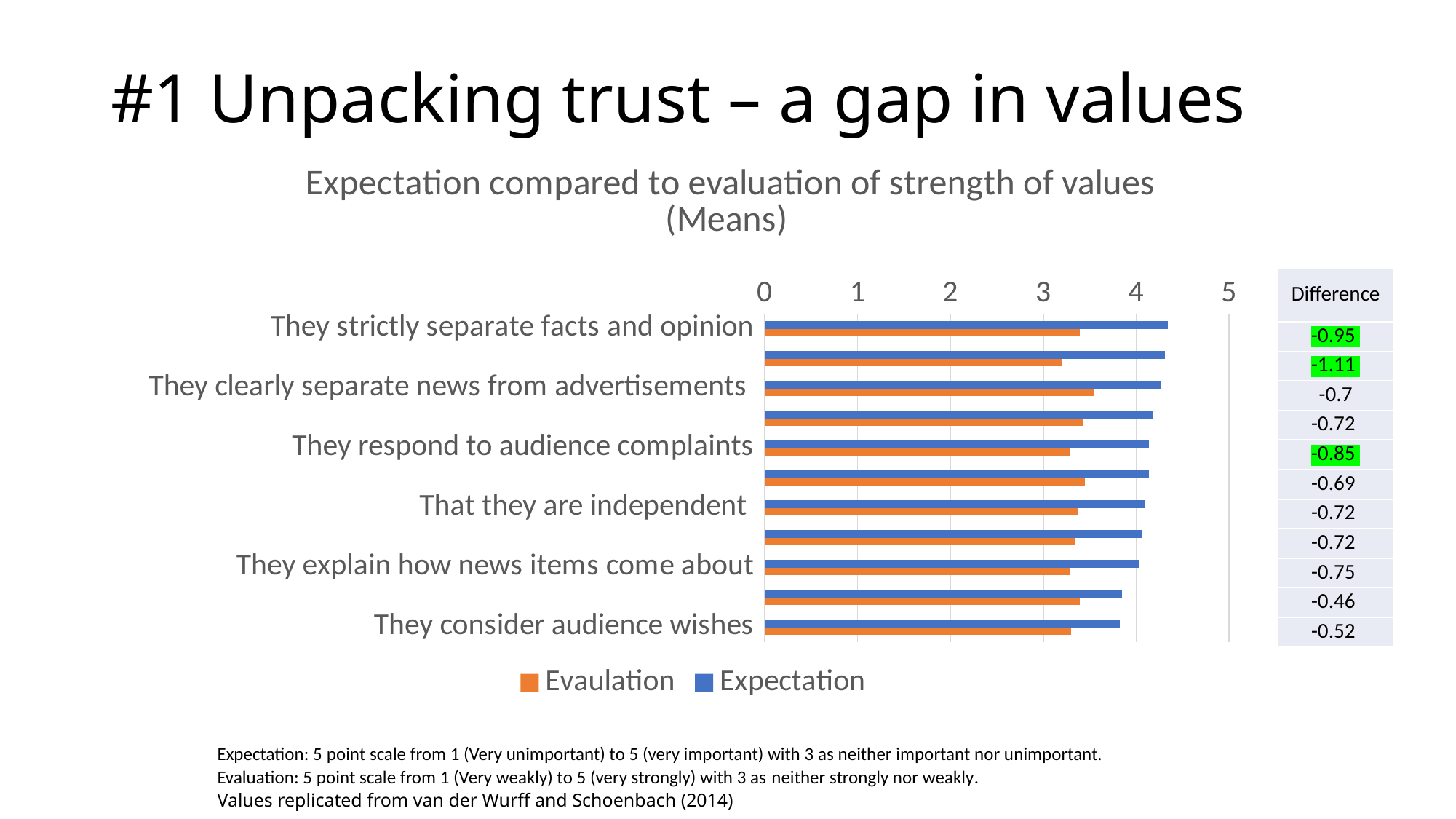
How many series does the chart legend list? 2 What kind of chart is shown on the slide? Bar chart Is the Expectation value for 'They consider audience wishes' greater or less than 4? less Is the Evaulation value for 'They consider audience wishes' greater or less than 3? greater Is the Expectation value for 'They strictly separate facts and opinion' greater or less than 4? greater What are the two series named in the chart legend? Evaulation and Expectation For 'They respond to audience complaints', which is larger: the Expectation value or the Evaulation value? Expectation For 'That they are independent', which series has the longer bar, Expectation or Evaulation? Expectation What is the highest value shown on the chart's horizontal axis? 5 How many pairs of bars (categories) are plotted in the chart? 11 What is the title of the chart? Expectation compared to evaluation of strength of values (Means)